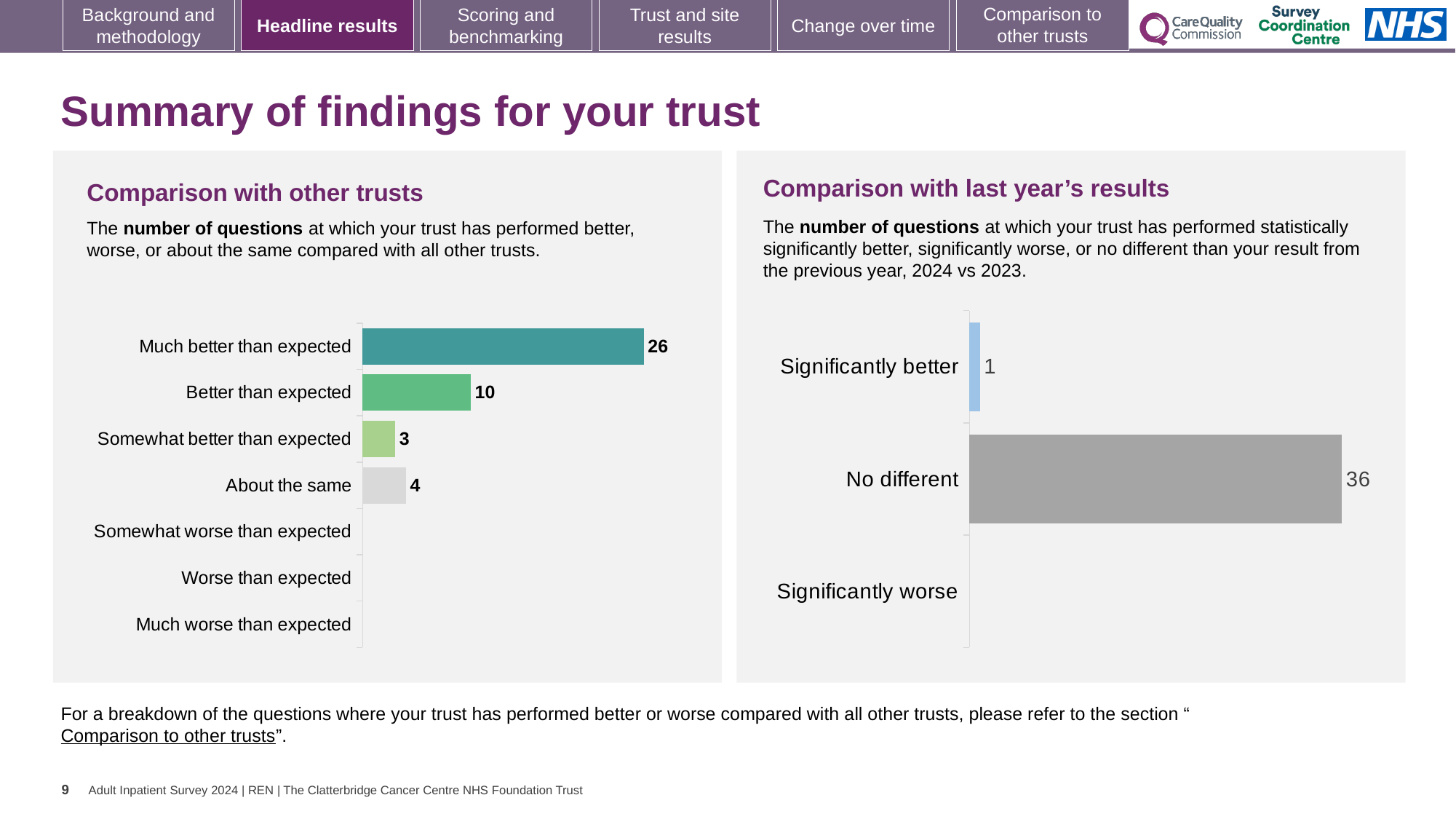
In the 'Comparison with other trusts' chart, what is the difference between 'Much better than expected' and 'Better than expected'? 16 How many categories are shown in the 'Comparison with last year's results' chart? 3 What kind of chart is the 'Comparison with other trusts' chart? Bar chart In the 'Comparison with other trusts' chart, what is the value for 'Better than expected'? 10 In the 'Comparison with last year's results' chart, what is the difference between 'No different' and 'Significantly better'? 35 How many categories are listed on the y axis of the 'Comparison with other trusts' chart? 7 In the 'Comparison with other trusts' chart, what is the value for 'About the same'? 4 In the 'Comparison with other trusts' chart, which category has the highest value? Much better than expected In the 'Comparison with last year's results' chart, what is the value for 'No different'? 36 In the 'Comparison with other trusts' chart, how many questions were 'Much better than expected'? 26 In the 'Comparison with other trusts' chart, which is larger: 'Somewhat better than expected' or 'About the same'? About the same In the 'Comparison with last year's results' chart, what is the value for 'Significantly better'? 1